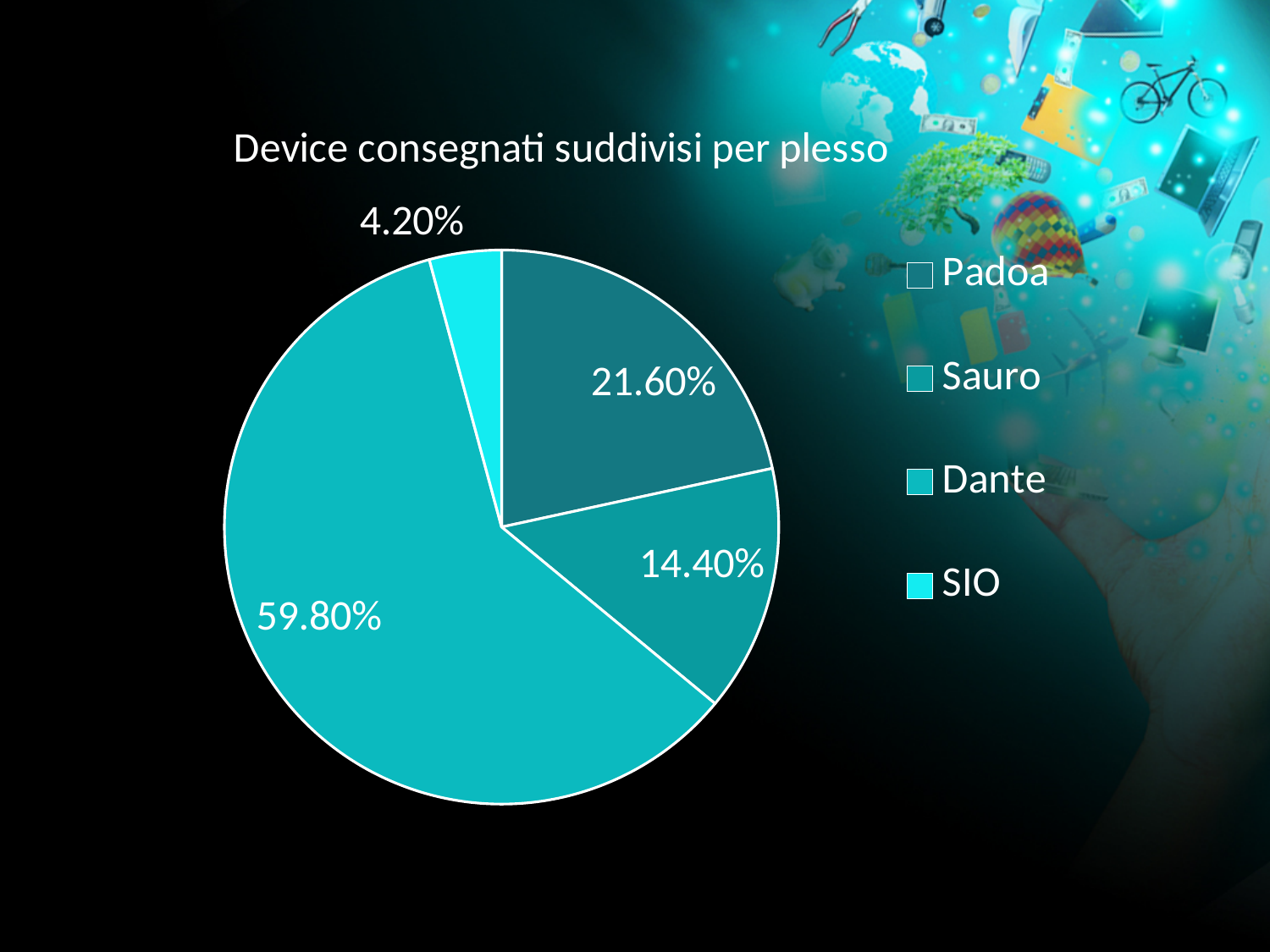
Which is larger, the share for Padoa or the share for Sauro? Padoa Which plesso has the largest slice of the pie? Dante How many entries does the legend list? 4 What share of the pie does Padoa have? 21.60% What share of the pie does Dante have? 59.80% What kind of chart is shown on the slide? pie chart How many slices does the pie chart have? 4 What is the title of the pie chart? Device consegnati suddivisi per plesso What is the difference in percentage points between Padoa and Sauro? 7.20% What share of the pie does SIO have? 4.20% Which plesso has the smallest slice of the pie? SIO